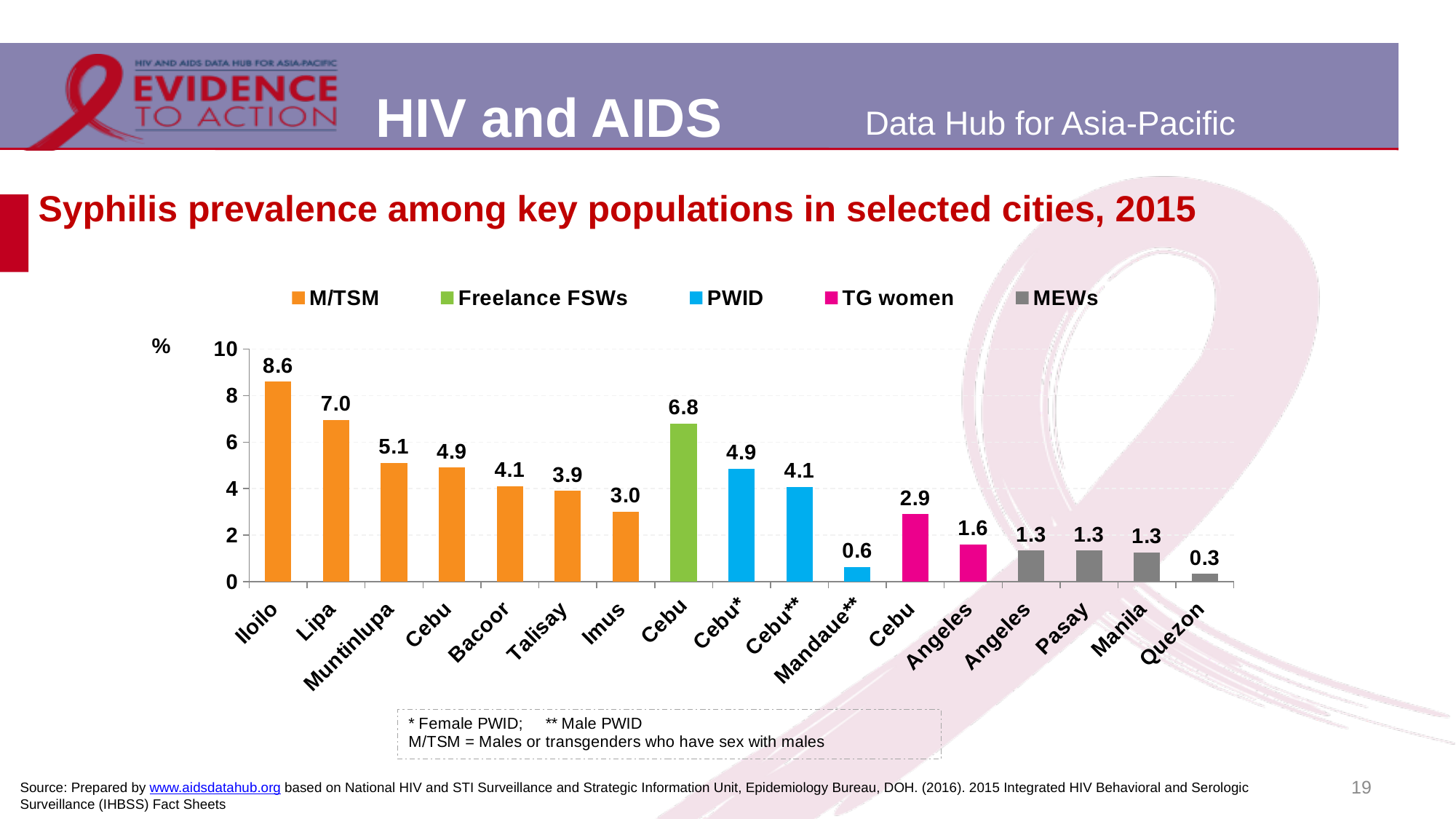
What is the syphilis prevalence among Freelance FSWs in Cebu? 6.8 What is the syphilis prevalence among M/TSM in Iloilo? 8.6 What is the syphilis prevalence among MEWs in Quezon? 0.3 What is the difference between the syphilis prevalence among M/TSM in Iloilo and in Lipa? 1.6 What is the syphilis prevalence among male PWID (Cebu**) in Cebu? 4.1 Which is larger: the syphilis prevalence among TG women in Cebu or among TG women in Angeles? Cebu How many series does the legend list? 5 Which city has the highest syphilis prevalence among M/TSM? Iloilo Is the syphilis prevalence among M/TSM in Muntinlupa greater or less than 4? greater What kind of chart is shown on the slide? Bar chart Which bar shows the lowest syphilis prevalence on the chart? Quezon (MEWs) How many bars are plotted on the chart? 17